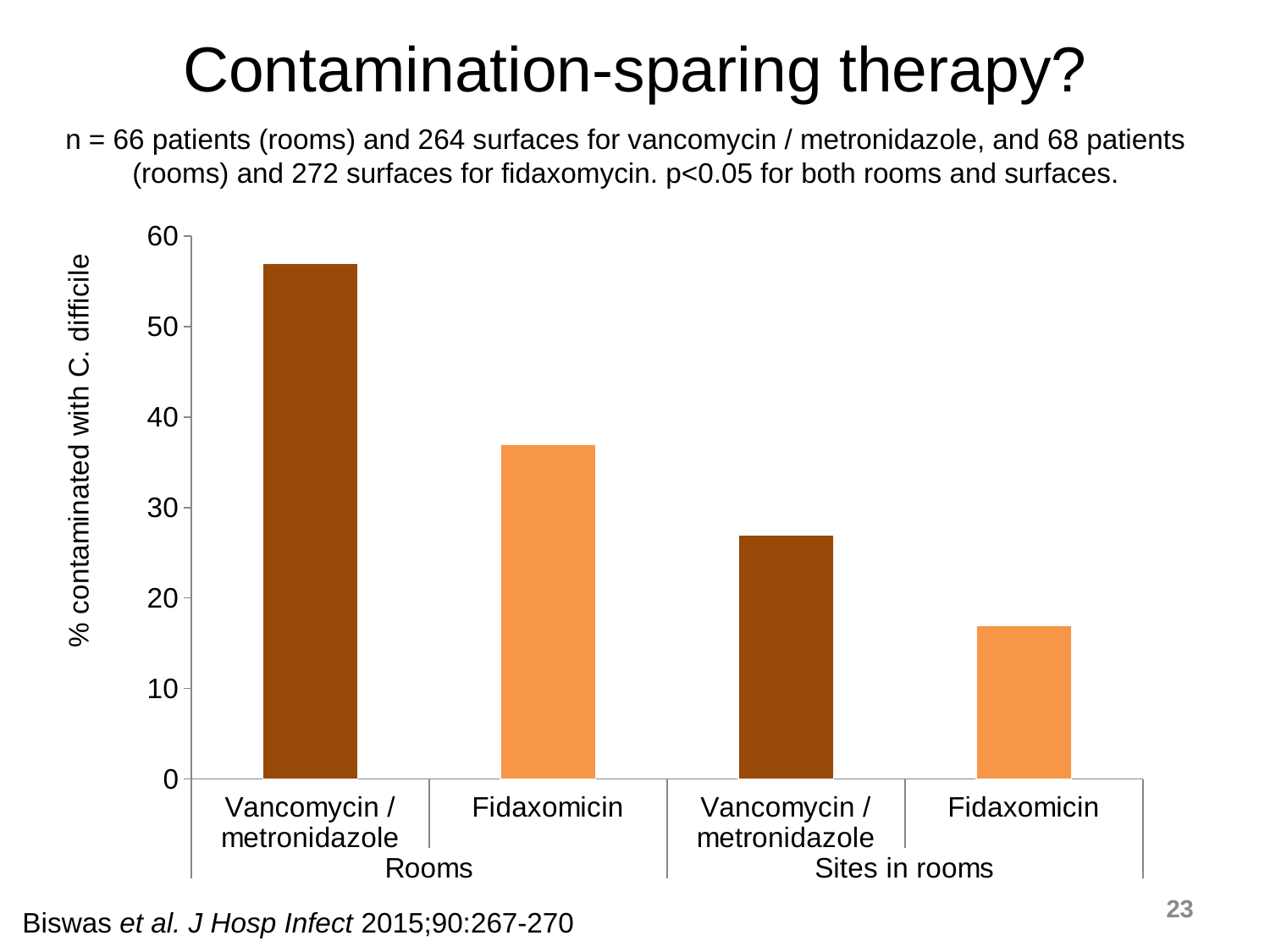
Do the bar values rise or fall from left to right across the chart? fall Which bar has the highest % contaminated with C. difficile? Vancomycin / metronidazole (Rooms) What is the label of the vertical axis? % contaminated with C. difficile Is the value for Fidaxomicin in the Rooms group greater or less than 40? less Is the value for Fidaxomicin in the Sites in rooms group greater or less than 20? less What kind of chart is shown on the slide? bar chart Which is larger: Fidaxomicin in Rooms or Vancomycin / metronidazole in Sites in rooms? Fidaxomicin in Rooms How many bars are plotted in the chart? 4 In the Rooms group, which has the higher % contaminated: Vancomycin / metronidazole or Fidaxomicin? Vancomycin / metronidazole Which bar has the lowest % contaminated with C. difficile? Fidaxomicin (Sites in rooms) Is the value for Vancomycin / metronidazole in the Rooms group greater or less than 50? greater